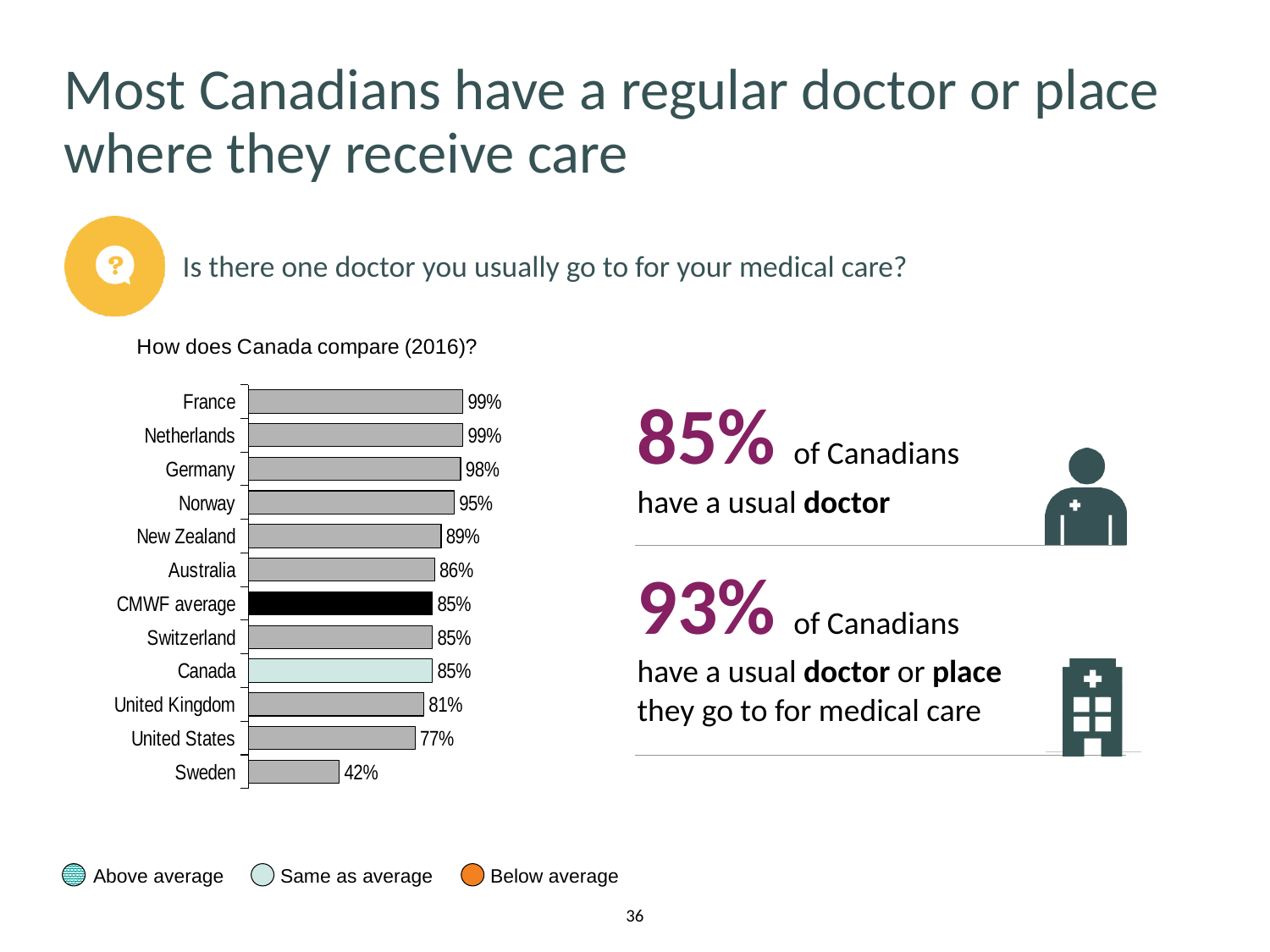
Which country has the lowest value in the chart? Sweden What is the title of the chart? How does Canada compare (2016)? What type of chart is shown on the slide? Bar chart What is the value for Sweden in the chart? 42% Which has a higher value, the United Kingdom or the United States? United Kingdom What is the value for the United States in the chart? 77% How many bars are shown in the chart? 12 What is the value for New Zealand in the chart? 89% Which has a higher value, Norway or Australia? Norway What is the value for Canada in the chart? 85% What is the difference between the values for Canada and Sweden? 43% What is the difference between the values for Germany and the United Kingdom? 17%